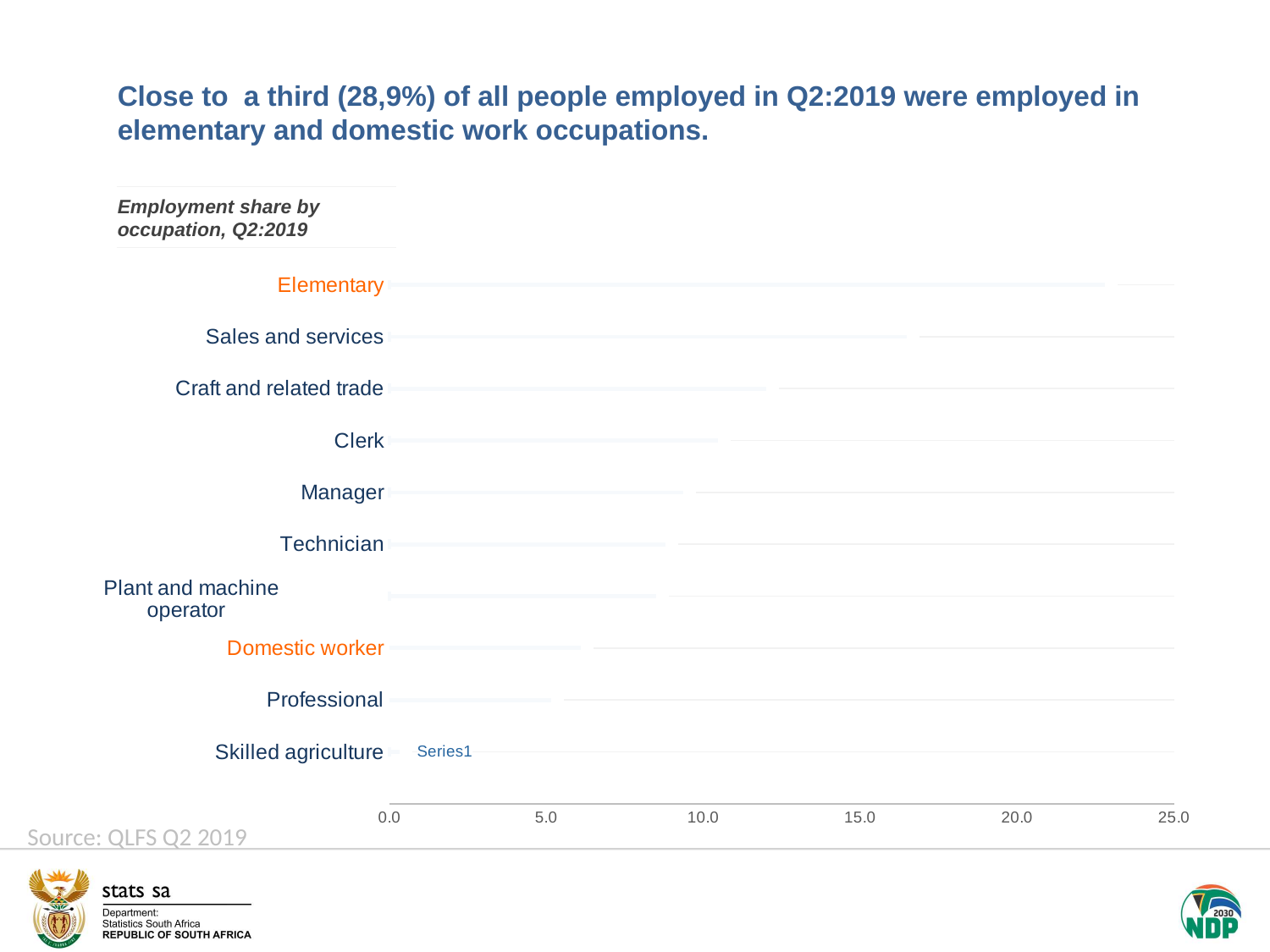
Which has the larger employment share, Elementary or Domestic worker? Elementary Is the value for Sales and services greater or less than 15.0? greater Which occupation has the lowest employment share in the chart? Skilled agriculture What is the title of the chart? Employment share by occupation, Q2:2019 Is the value for Elementary greater or less than 20.0? greater How many occupation categories are plotted in the chart? 10 Which has the larger employment share, Sales and services or Craft and related trade? Sales and services Which occupation has the highest employment share in the chart? Elementary What kind of chart is shown on the slide? bar chart Is the value for Domestic worker greater or less than 10.0? less